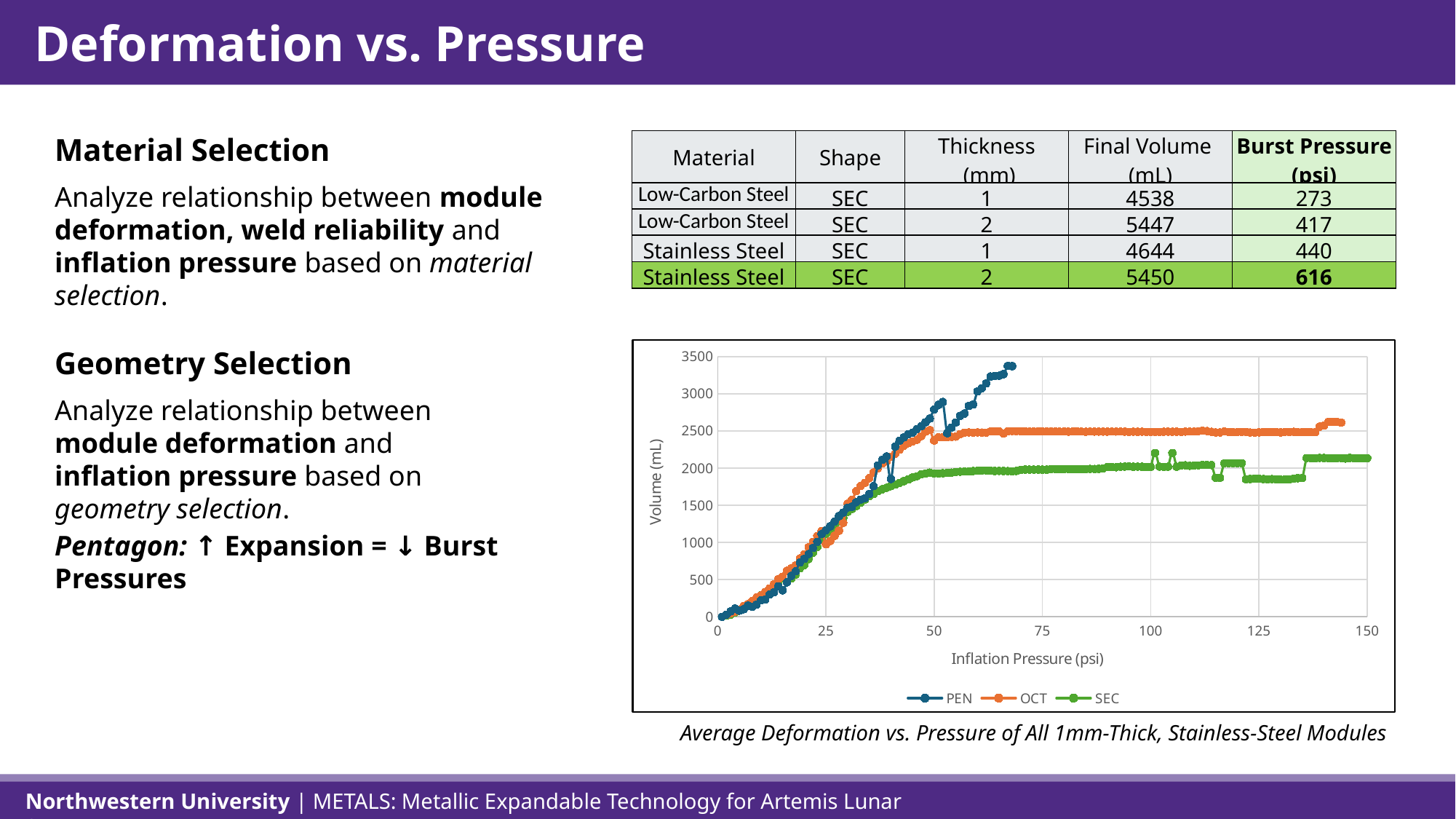
Is the volume of the PEN series at 50 psi greater or less than 2500 mL? greater Does the volume of the SEC series rise or fall as inflation pressure increases from 0 to 50 psi? rise Which series extends to the highest inflation pressure on the chart? SEC Which series plateaus at the lowest volume on the chart? SEC Is the volume of the OCT series at 100 psi greater or less than 2000 mL? greater Is the maximum volume reached by the PEN series greater or less than 3000 mL? greater What kind of chart is shown on the slide? line chart What is the label of the chart's x axis? Inflation Pressure (psi) Which series reaches the highest volume on the chart? PEN How many series does the chart legend list? 3 Which series has the higher volume at 100 psi, OCT or SEC? OCT